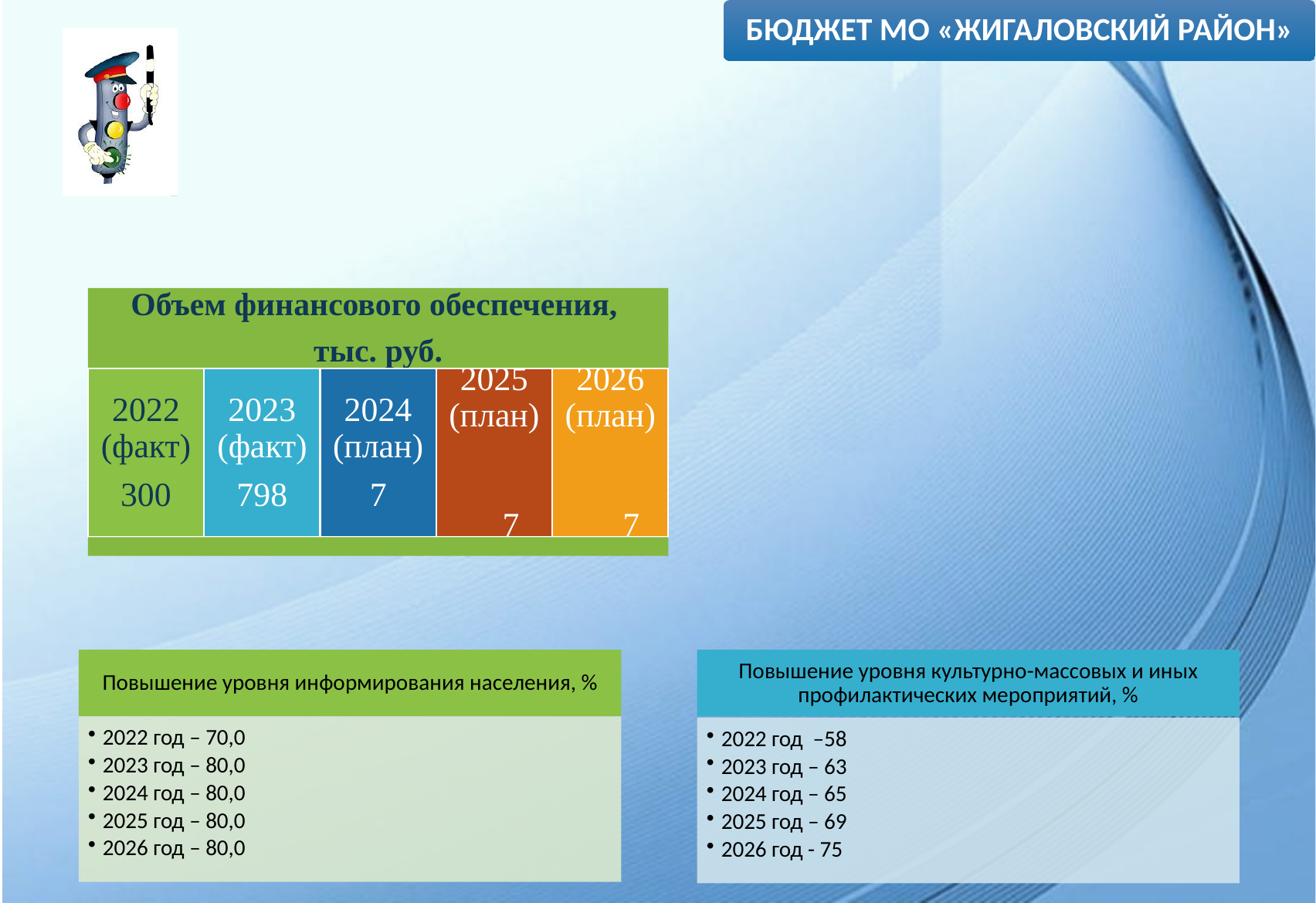
In the 'Объем финансового обеспечения, тыс. руб.' chart, what is the value for 2022 (факт)? 300 In the 'Объем финансового обеспечения, тыс. руб.' chart, what is the value for 2026 (план)? 7 In the 'Объем финансового обеспечения, тыс. руб.' chart, what is the value for 2023 (факт)? 798 In the 'Объем финансового обеспечения, тыс. руб.' chart, which year has the highest value? 2023 (факт) In the 'Объем финансового обеспечения, тыс. руб.' chart, what is the difference between the 2023 (факт) and 2022 (факт) values? 498 What unit is stated in the title of the 'Объем финансового обеспечения' chart? тыс. руб. In the 'Объем финансового обеспечения, тыс. руб.' chart, which is larger: the value for 2022 (факт) or 2024 (план)? 2022 (факт) In the 'Объем финансового обеспечения, тыс. руб.' chart, what is the total of the values for 2024 (план), 2025 (план) and 2026 (план)? 21 In the 'Объем финансового обеспечения, тыс. руб.' chart, what colour is the 2026 (план) block? orange In the 'Объем финансового обеспечения, тыс. руб.' chart, do the values rise or fall from 2023 (факт) to 2024 (план)? fall How many years are shown in the 'Объем финансового обеспечения, тыс. руб.' chart? 5 In the 'Объем финансового обеспечения, тыс. руб.' chart, what is the value for 2024 (план)? 7